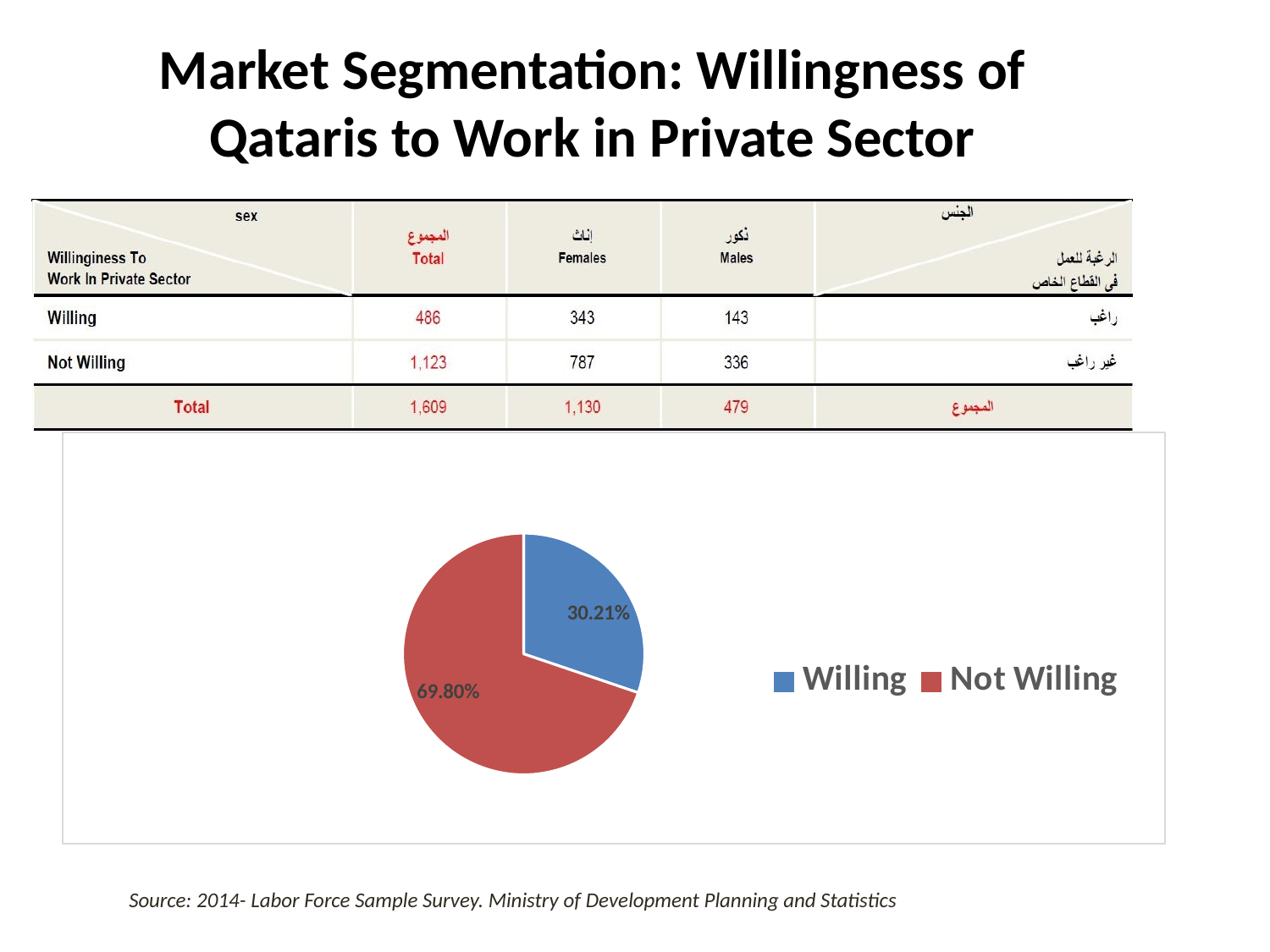
How many entries does the legend of the pie chart list? 2 How many slices does the pie chart have? 2 Which slice of the pie chart is the smallest? Willing What is the value shown for the Willing slice? 30.21% What is the difference in percentage points between the Not Willing slice and the Willing slice? 39.59% Which slice of the pie chart is the largest? Not Willing What kind of chart is shown on the slide? pie chart Which is larger, the Willing slice or the Not Willing slice? Not Willing What is the value shown for the Not Willing slice? 69.80% What colour is the Not Willing slice in the pie chart? red What share of the pie does the Not Willing slice represent? 69.80% What share of the pie does the Willing slice represent? 30.21%